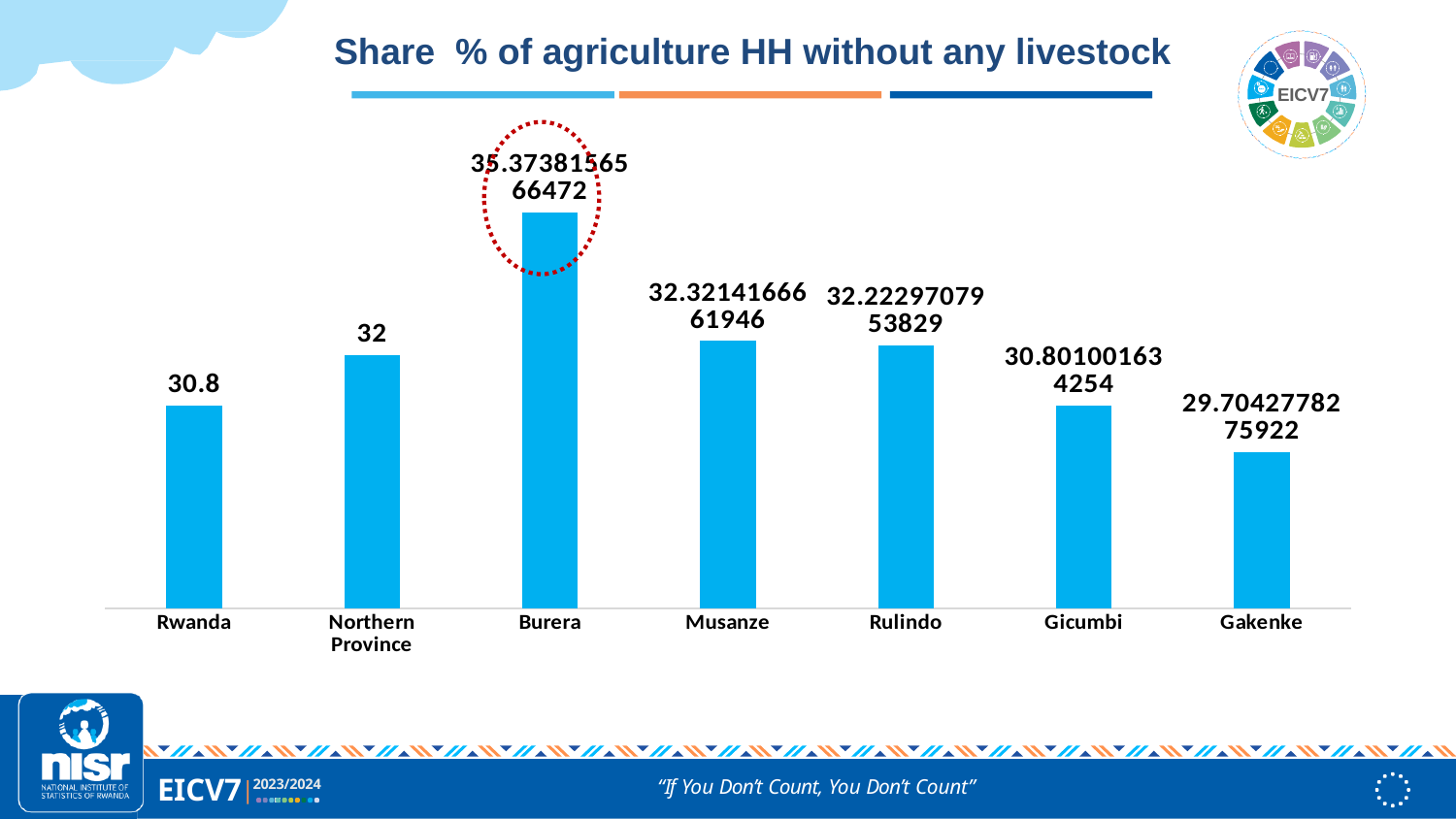
What is the value for Northern Province? 32 What is the value shown for Gakenke? 29.7042778275922 What kind of chart is shown on the slide? Bar chart What is the value for Rwanda? 30.8 What is the difference between the values for Northern Province and Rwanda? 1.2 Which category has the lowest value? Gakenke What is the title of the chart? Share % of agriculture HH without any livestock How many categories are shown on the x axis? 7 Which category has the highest value? Burera Which is larger, the value for Gicumbi or the value for Gakenke? Gicumbi What is the value shown for Burera? 35.3738156566472 Which is larger, the value for Musanze or the value for Rulindo? Musanze